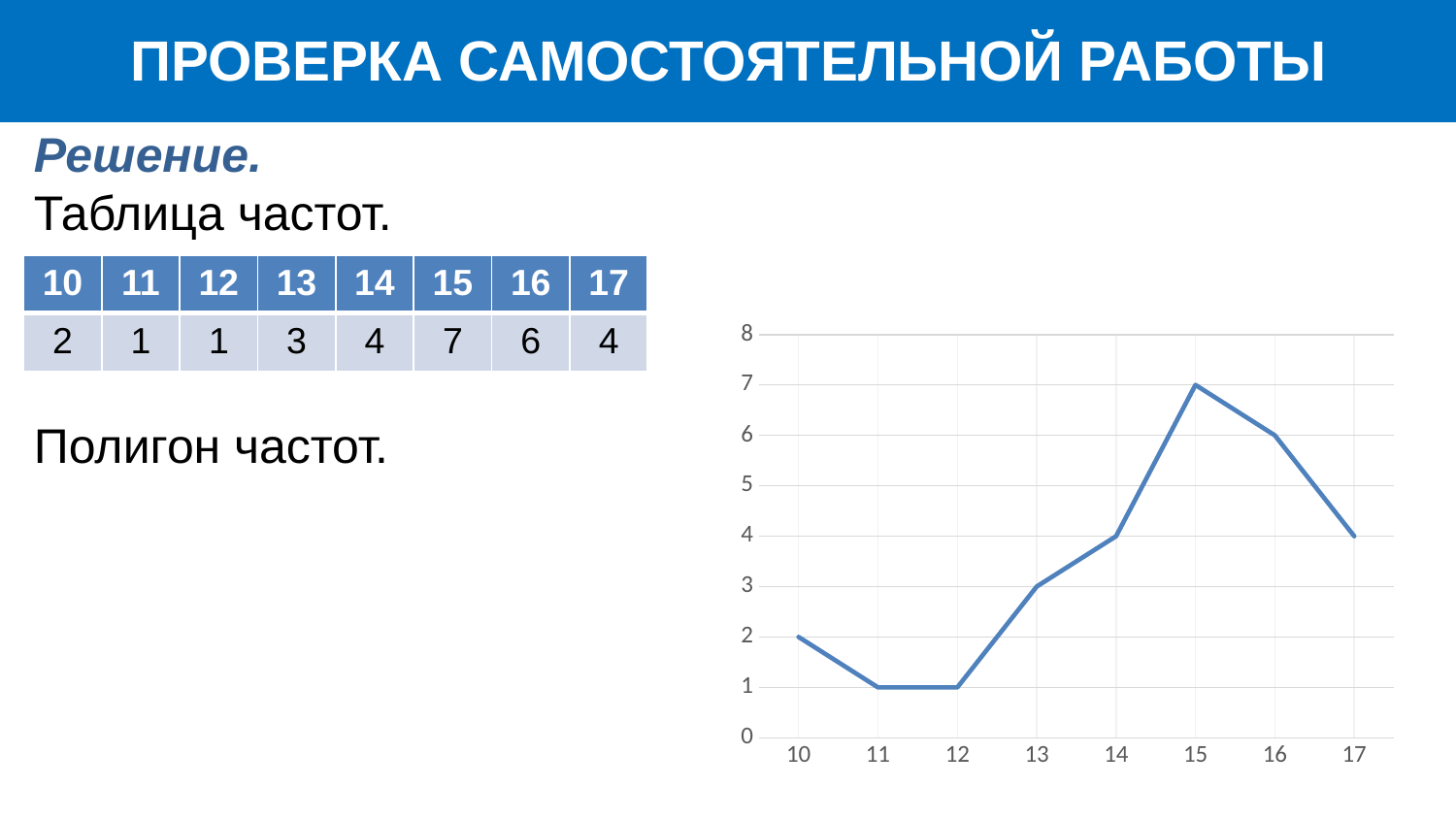
Does the line chart rise or fall between x = 12 and x = 15? rise At which x value does the line chart reach its highest point? 15 How many points are plotted on the line chart? 8 Is the value at x = 13 on the line chart greater or less than 2? greater What is the value at x = 17 on the line chart? 4 What is the value at x = 10 on the line chart? 2 What is the difference between the values at x = 15 and x = 14 on the line chart? 3 What kind of chart is shown on the slide? line chart What is the lowest value plotted on the line chart? 1 Which is larger on the line chart: the value at x = 16 or the value at x = 17? 16 What is the value at x = 15 on the line chart? 7 What is the maximum value shown on the vertical axis of the line chart? 8